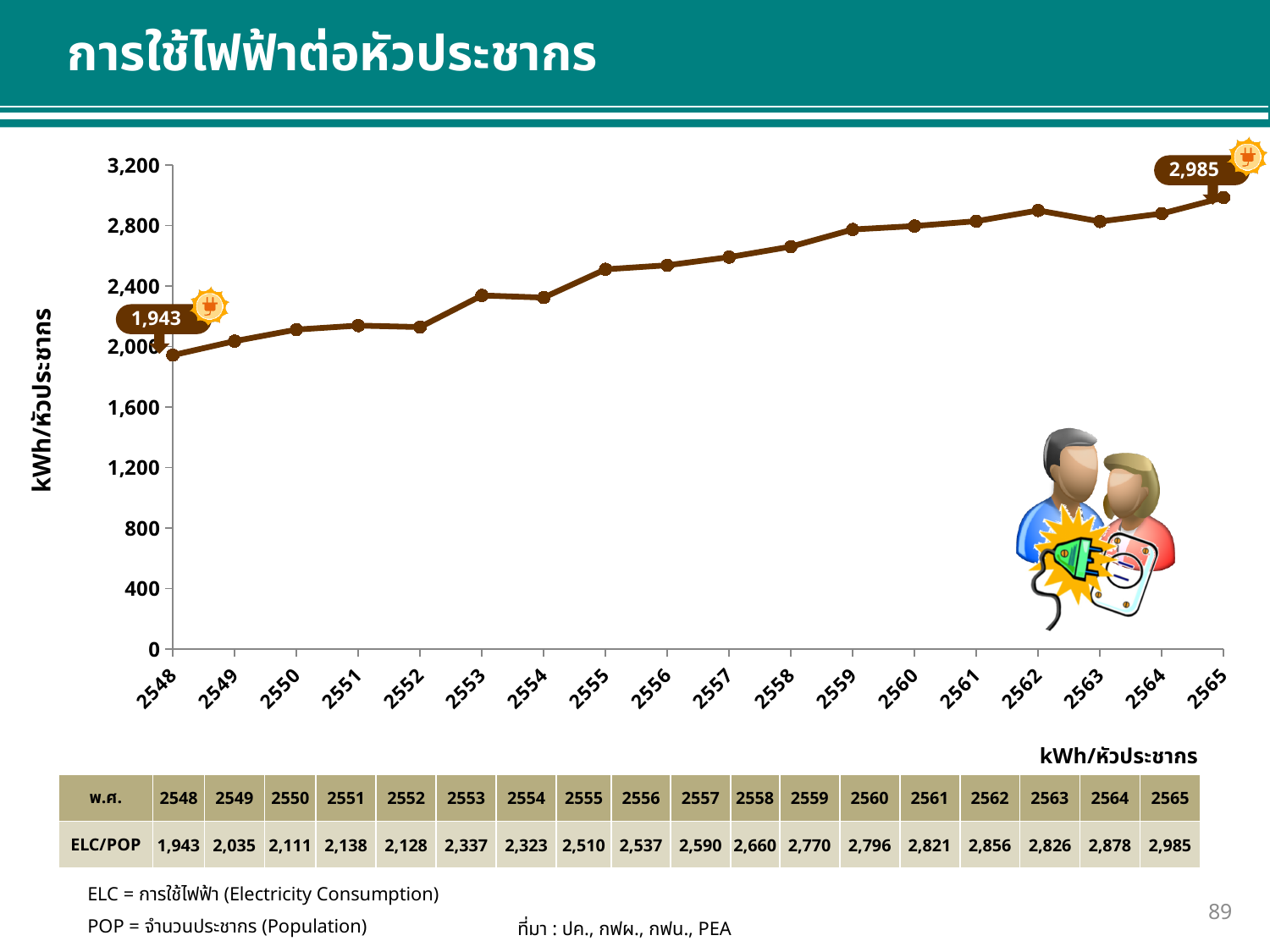
What is the label on the vertical axis? kWh/หัวประชากร What is the value for 2548? 1,943 Which year has the lowest value? 2548 Is the value for 2555 greater or less than 2,400? greater What kind of chart is shown? line chart What is the value for 2553? 2,337 Which year has the highest value? 2565 Which is larger, the value for 2562 or the value for 2563? 2562 What is the difference between the values for 2565 and 2548? 1,042 How many years are plotted on the chart? 18 Do the values generally rise or fall from 2548 to 2565? rise What is the value for 2565? 2,985